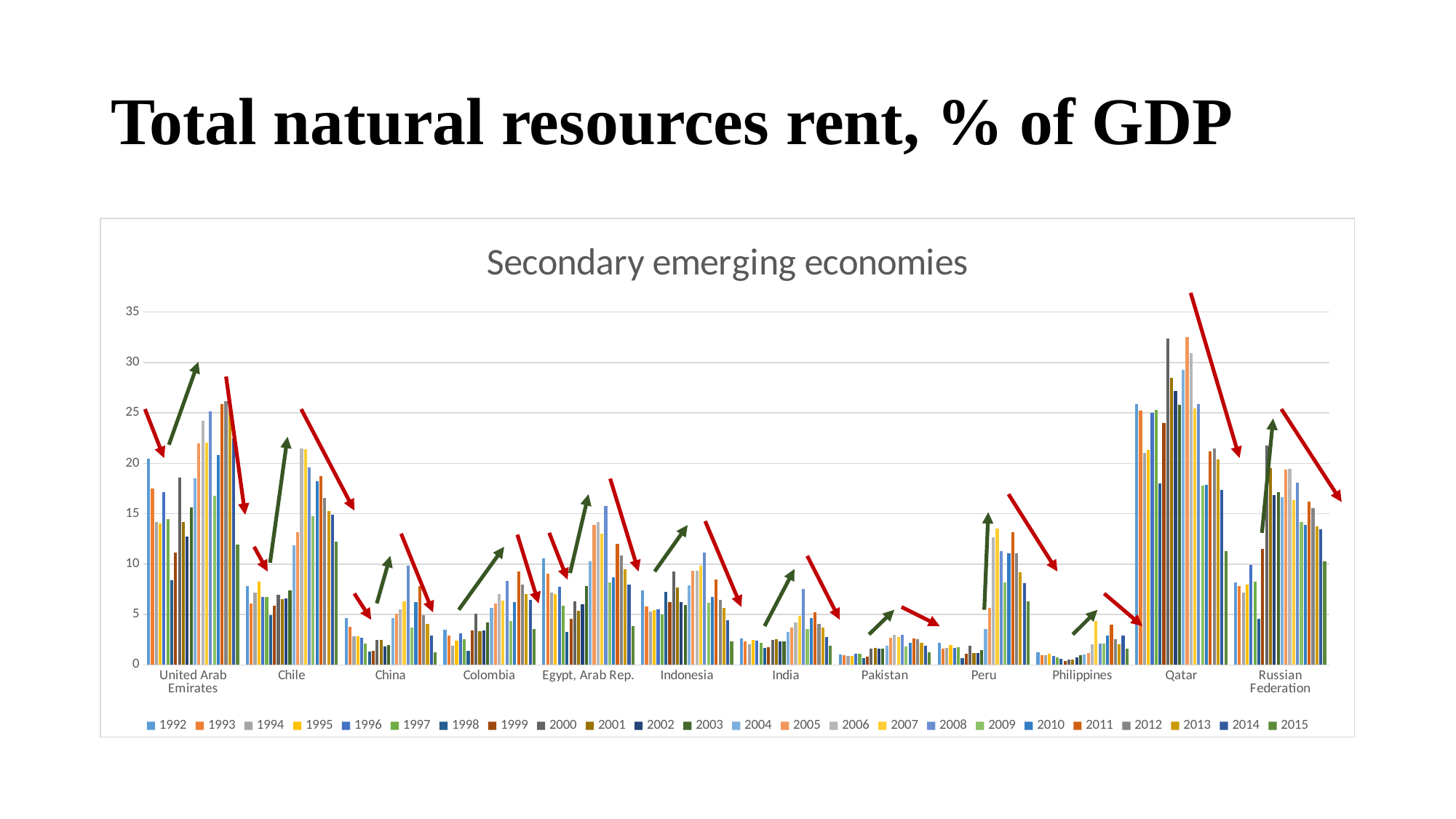
Are all the bars for Philippines greater or less than 10? less What is the first year listed in the chart legend? 1992 Which country has taller bars overall, Qatar or Pakistan? Qatar Is the tallest bar for United Arab Emirates greater or less than 25? greater What type of chart is shown on the slide? Bar chart How many countries (categories) are shown on the x axis of the chart? 12 How many series (years) does the chart legend list? 24 Are all the bars for Pakistan greater or less than 5? less Which country has taller bars overall, Russian Federation or India? Russian Federation What is the title of the chart? Secondary emerging economies Which country has the tallest bars in the chart? Qatar